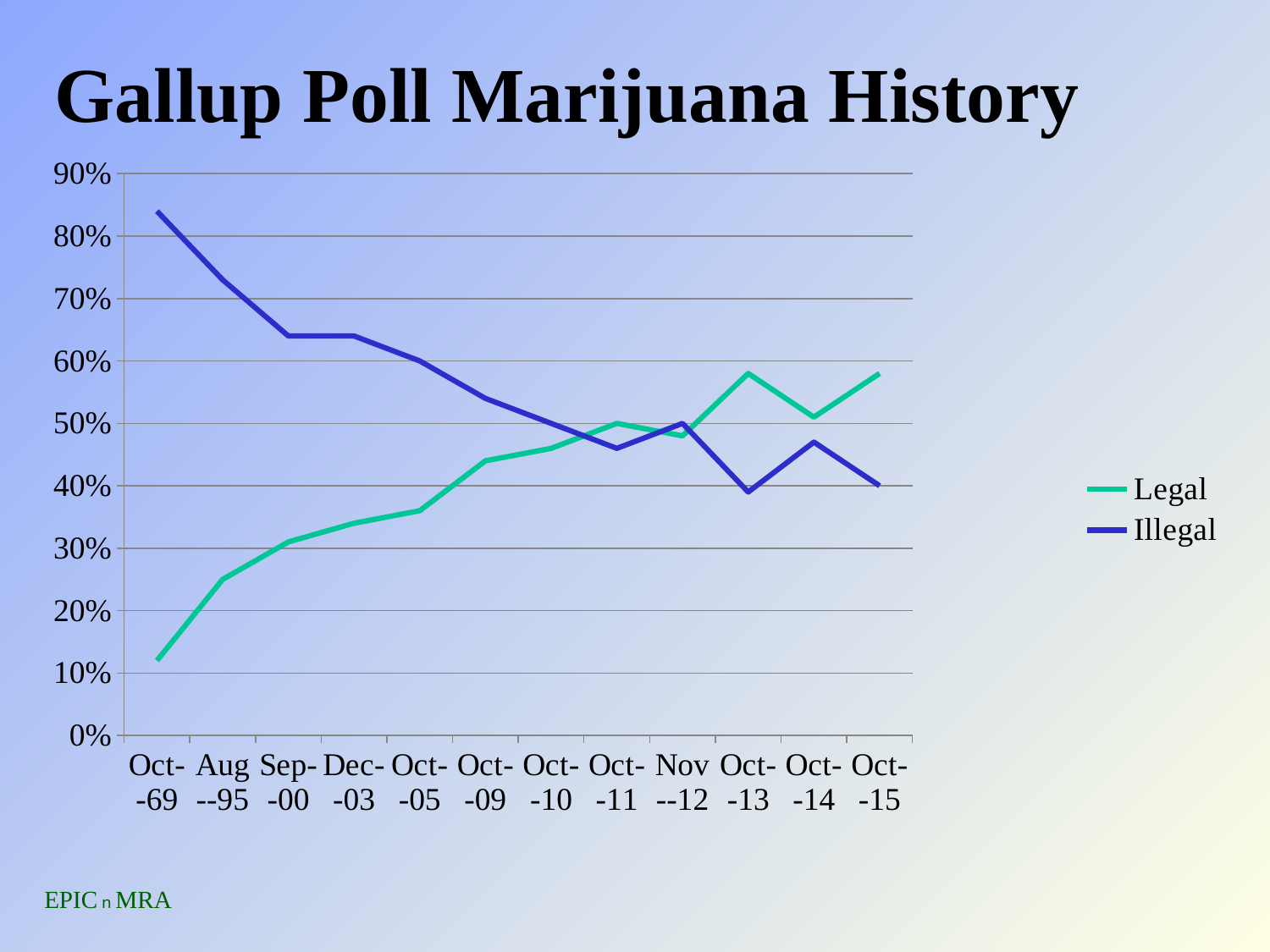
At which date is the Legal series lowest? Oct-69 How many series does the legend list? 2 Is the Legal value for Oct-13 greater or less than 50%? greater How many dates are plotted along the x axis? 12 At which date is the Illegal series highest? Oct-69 At Oct-15, which series has the larger value, Legal or Illegal? Legal Is the Illegal value for Oct-69 greater or less than 80%? greater Is the Illegal value for Sep-00 greater or less than 60%? greater Does the Illegal series generally rise or fall from Oct-69 to Oct-15? fall What kind of chart is shown on the slide? line chart